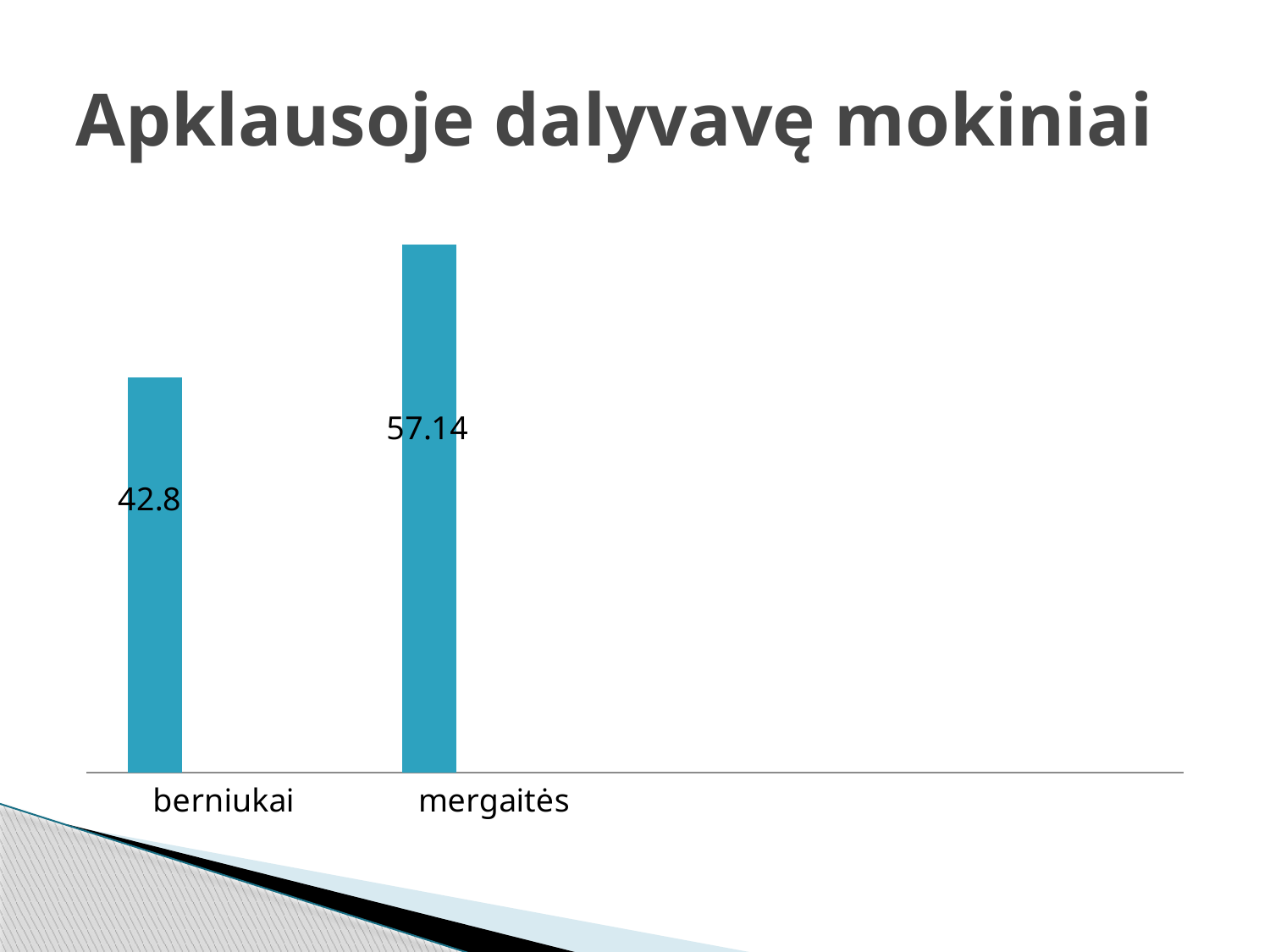
What is the total of the two values shown in the chart? 99.94 Which category has the lowest value? berniukai What kind of chart is shown on the slide? bar chart What colour are the bars in the chart? blue What is the value for mergaitės? 57.14 Which is larger, the value for berniukai or the value for mergaitės? mergaitės What is the difference between the values for mergaitės and berniukai? 14.34 How many categories are shown in the chart? 2 Which category has the highest value? mergaitės What is the value for berniukai? 42.8 What is the title of the slide containing the chart? Apklausoje dalyvavę mokiniai